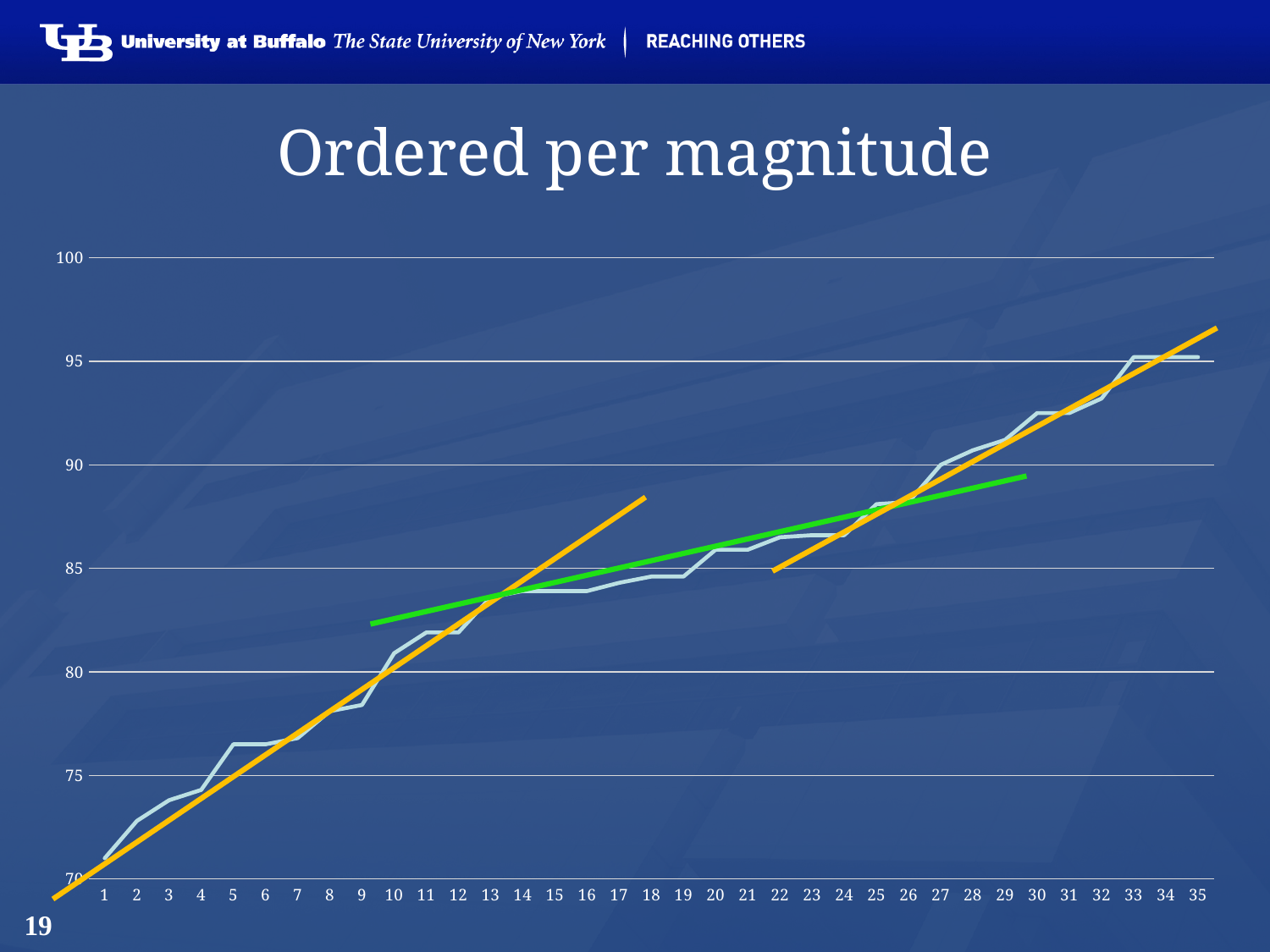
What kind of chart is shown on the slide? line chart Is the value for point 9 greater or less than 80? less Is the value for point 15 greater or less than 85? less Is the value for point 5 greater or less than 75? greater Which has the larger value on the light blue line, point 10 or point 30? point 30 Do the values of the light blue line rise or fall as you move from left to right along the x axis? rise What is the title of the chart? Ordered per magnitude Which x-axis point has the lowest value on the light blue line? 1 How many points are plotted along the x axis of the chart? 35 What is the highest value shown on the y axis of the chart? 100